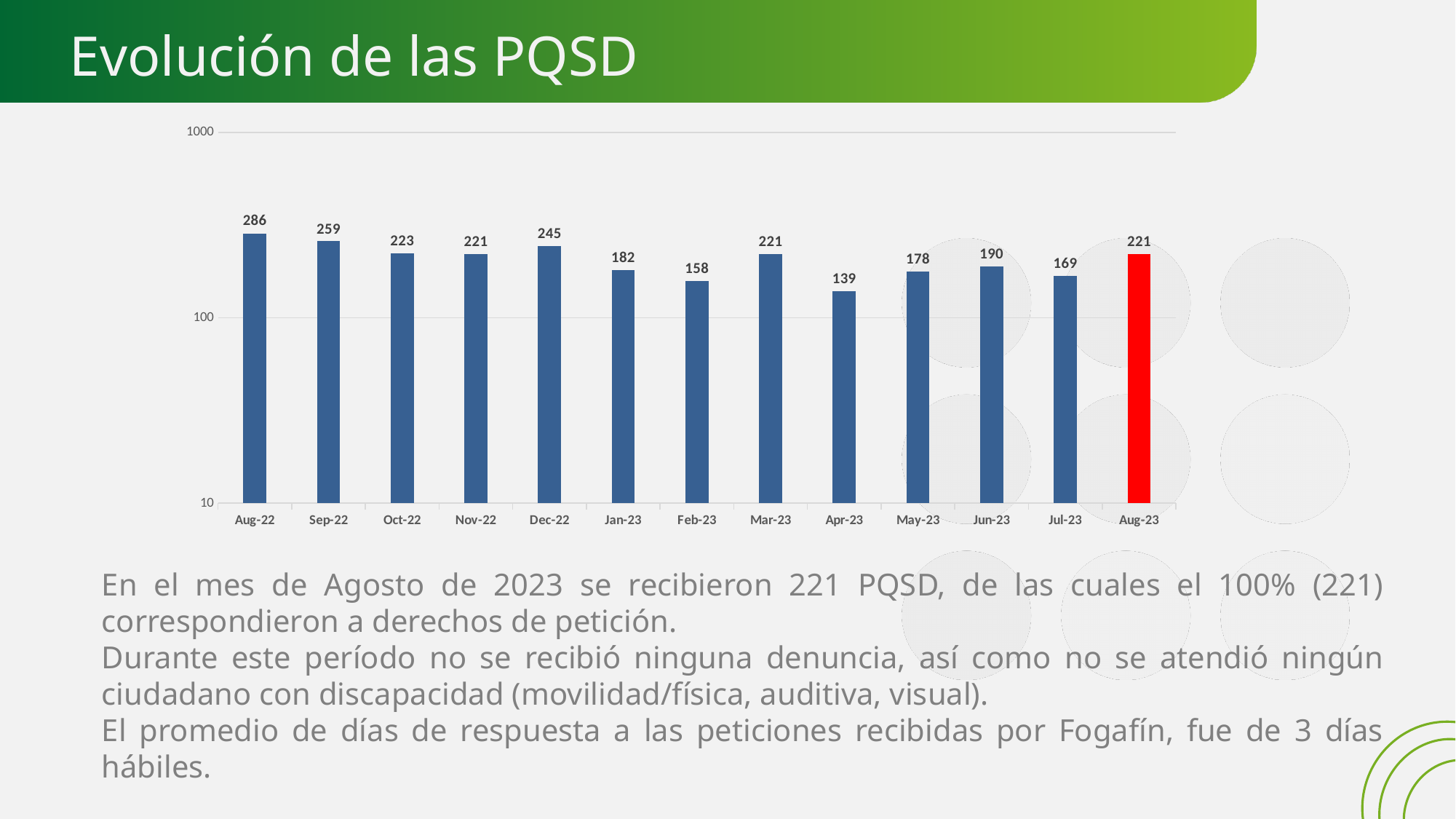
Which month has the highest value? Aug-22 What is the value for Apr-23? 139 What kind of chart is shown on the slide? bar chart Which month has the lowest value? Apr-23 What is the value for Aug-22? 286 What is the difference between the values for Jun-23 and Jul-23? 21 How many months are shown on the x axis? 13 What is the difference between the values for Aug-22 and Aug-23? 65 Is the value for Feb-23 greater or less than 100? greater Which bar is coloured red? Aug-23 Which is larger, the value for Dec-22 or the value for Jan-23? Dec-22 What is the value for Aug-23? 221